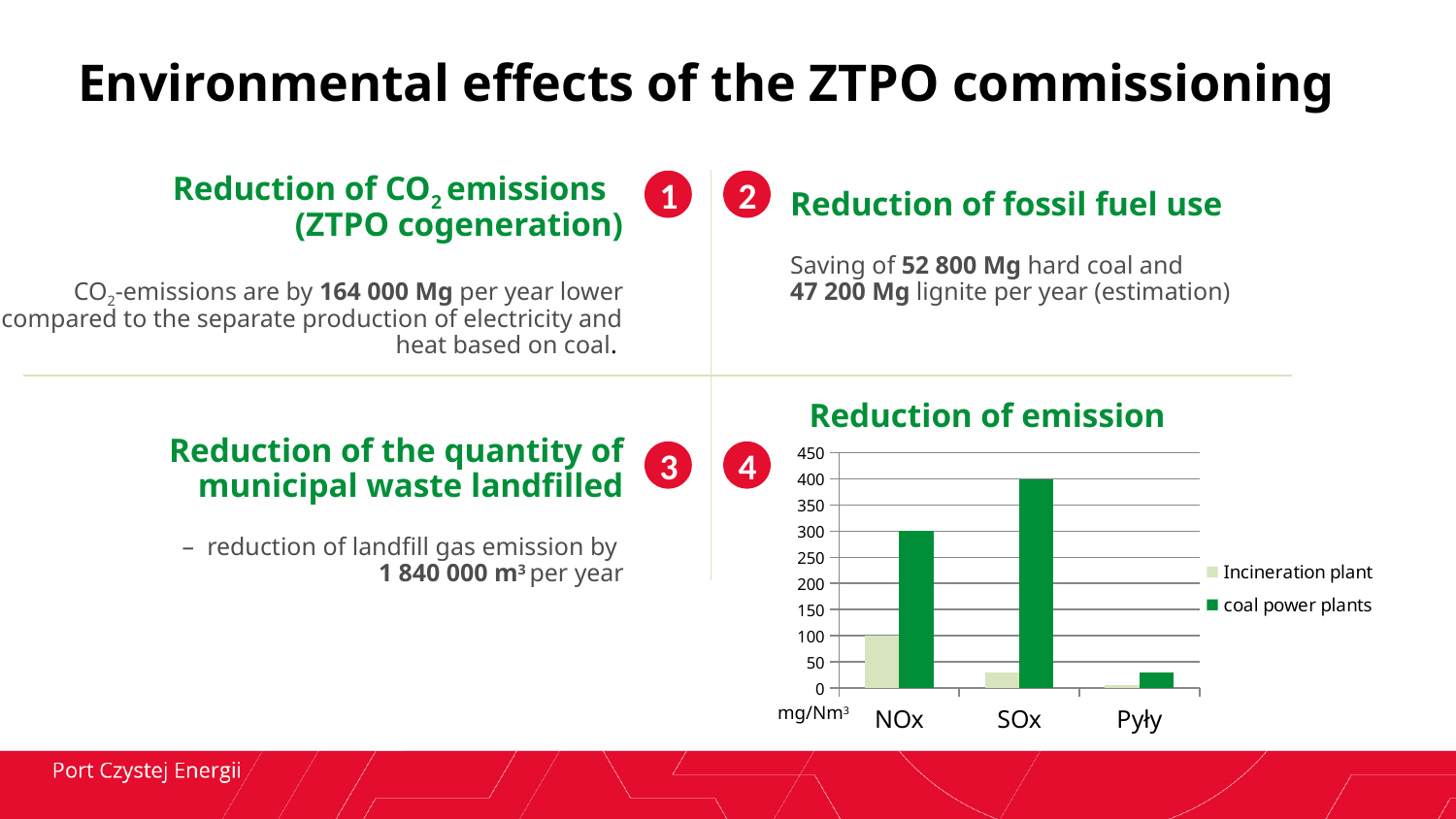
How many categories are shown on the x axis of the "Reduction of emission" chart? 3 In the "Reduction of emission" chart, which category has the highest value for coal power plants? SOx In the "Reduction of emission" chart, is the coal power plants value for Pyły greater or less than 50? less In the "Reduction of emission" chart, which is larger for NOx: the incineration plant or coal power plants? coal power plants In the "Reduction of emission" chart, which category has the lowest value for the incineration plant? Pyły What unit is shown at the bottom left of the "Reduction of emission" chart's axis? mg/Nm³ What kind of chart is shown under the title "Reduction of emission"? bar chart In the "Reduction of emission" chart, what is the value for coal power plants for SOx? 400 How many series does the legend of the "Reduction of emission" chart list? 2 In the "Reduction of emission" chart, what is the value for coal power plants for NOx? 300 In the "Reduction of emission" chart, what is the value for the incineration plant for NOx? 100 In the "Reduction of emission" chart, is the incineration plant value for SOx greater or less than 50? less